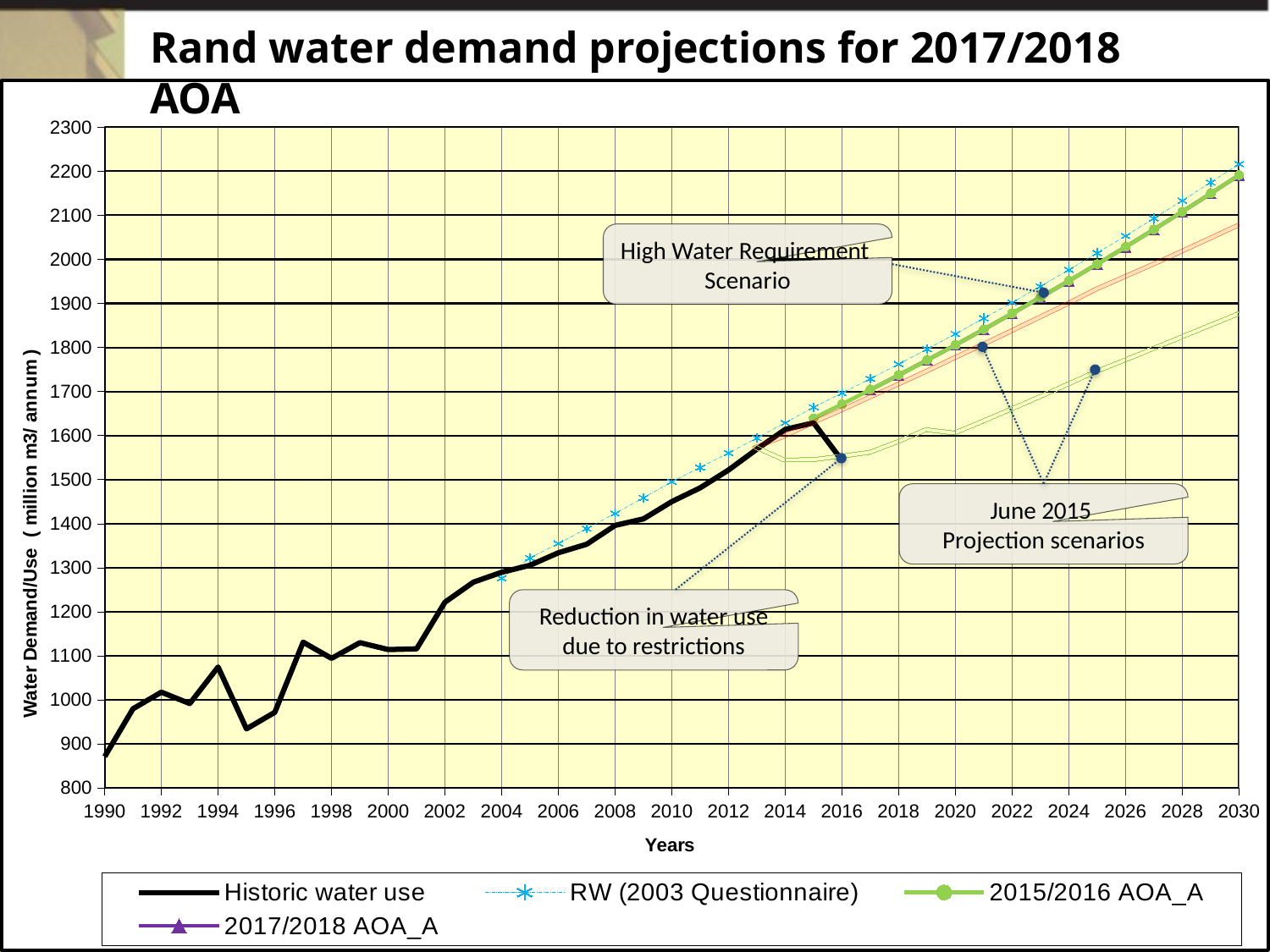
Does the RW (2003 Questionnaire) series rise or fall from 2004 to 2030? rise Is the Historic water use value for 2003 greater or less than 1200? greater Is the RW (2003 Questionnaire) value for 2030 greater or less than 2100? greater Which is larger for Historic water use: the value in 2014 or the value in 2016? 2014 What kind of chart is shown on the slide? Line chart Which is larger for Historic water use: the value in 1997 or the value in 1995? 1997 What is the title of the chart? Rand water demand projections for 2017/2018 AOA What is the label of the vertical axis? Water Demand/Use ( million m3/ annum) Is the 2015/2016 AOA_A value for 2030 greater or less than 2100? greater How many series does the legend list? 4